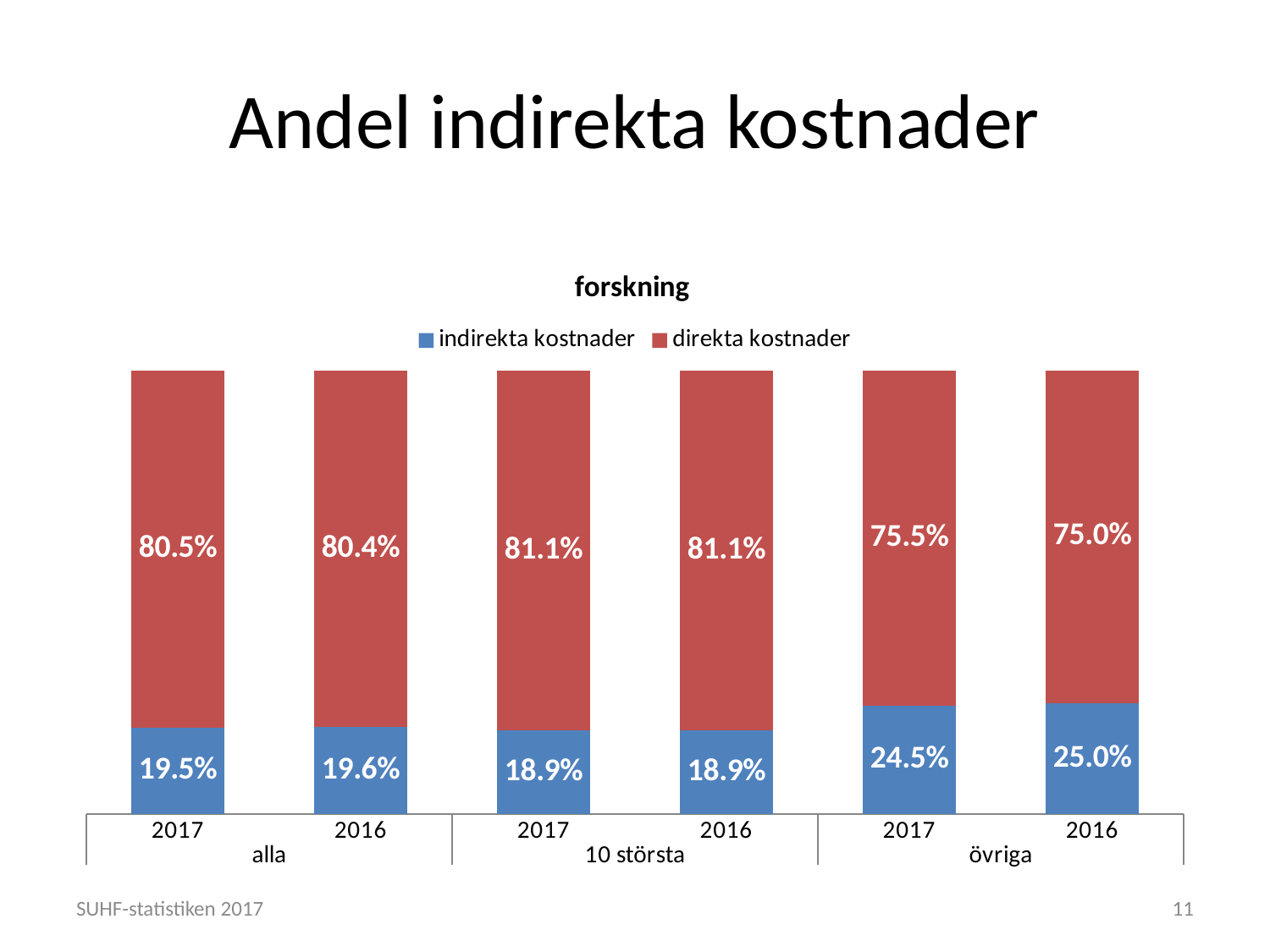
Is the indirekta kostnader value larger for övriga 2017 or for 10 största 2017? övriga 2017 What kind of chart is shown on the slide? Stacked bar chart What is the title of the chart? forskning How many bars are shown in the chart? 6 What is the value of direkta kostnader for 10 största in 2016? 81.1% What is the value of indirekta kostnader for övriga in 2016? 25.0% How many series does the legend list? 2 Which bar has the highest value for indirekta kostnader? övriga 2016 What is the difference between indirekta kostnader for övriga 2017 and alla 2017? 5.0% What is the value of direkta kostnader for övriga in 2017? 75.5% What is the value of indirekta kostnader for alla in 2017? 19.5% Which group has the lowest indirekta kostnader share in 2017? 10 största